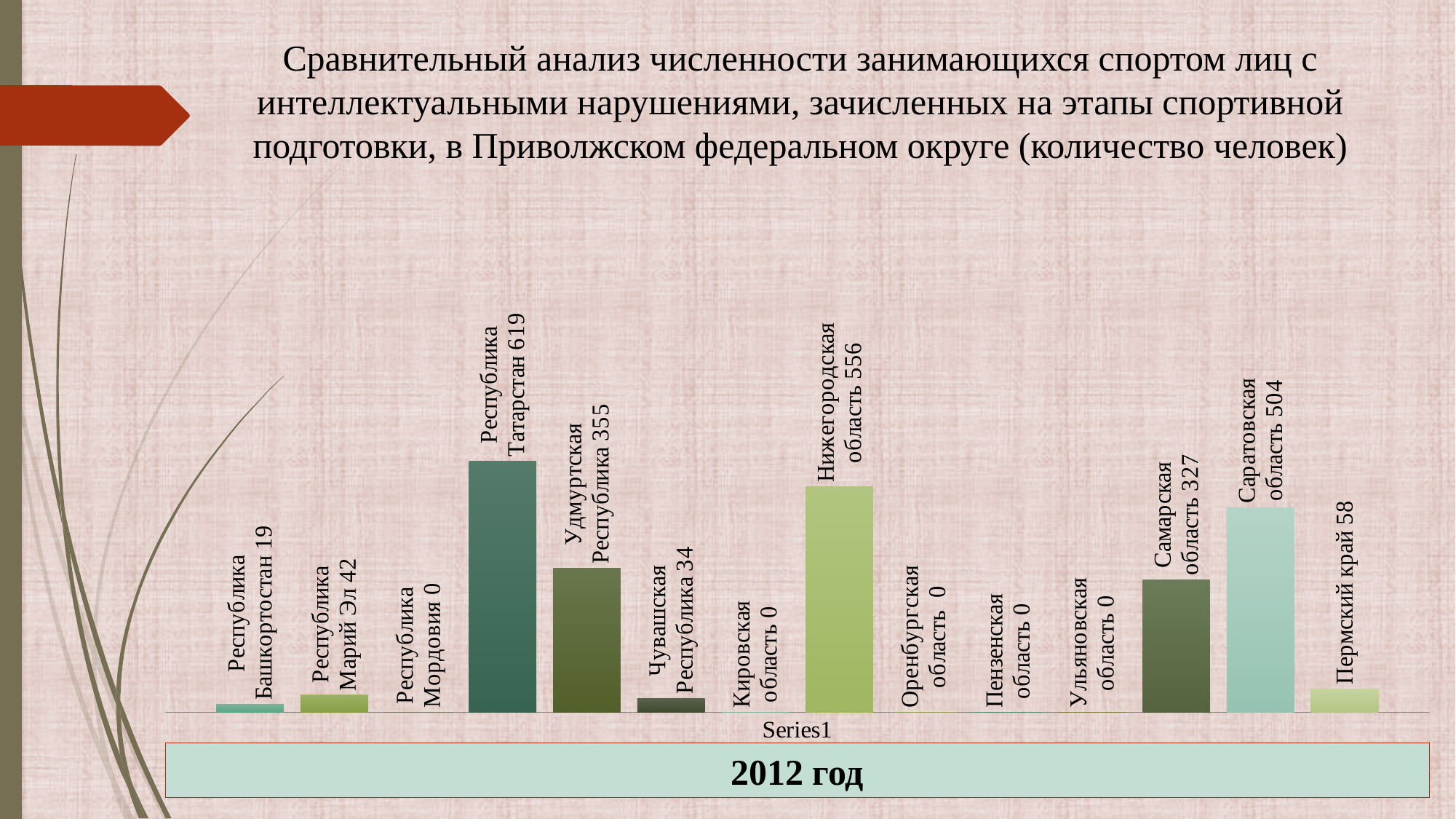
What is the value for Республика Татарстан? 619 What is the value for Самарская область? 327 What kind of chart is shown on the slide? Bar chart What is the difference between the values for Республика Татарстан and Нижегородская область? 63 Which is larger, the value for Удмуртская Республика or the value for Самарская область? Удмуртская Республика What is the difference between the values for Саратовская область and Самарская область? 177 What year is shown in the label below the chart? 2012 год Which region has the highest value? Республика Татарстан How many regions are shown in the chart? 14 Which is larger, the value for Республика Марий Эл or the value for Чувашская Республика? Республика Марий Эл What is the value for Нижегородская область? 556 What is the value for Пермский край? 58